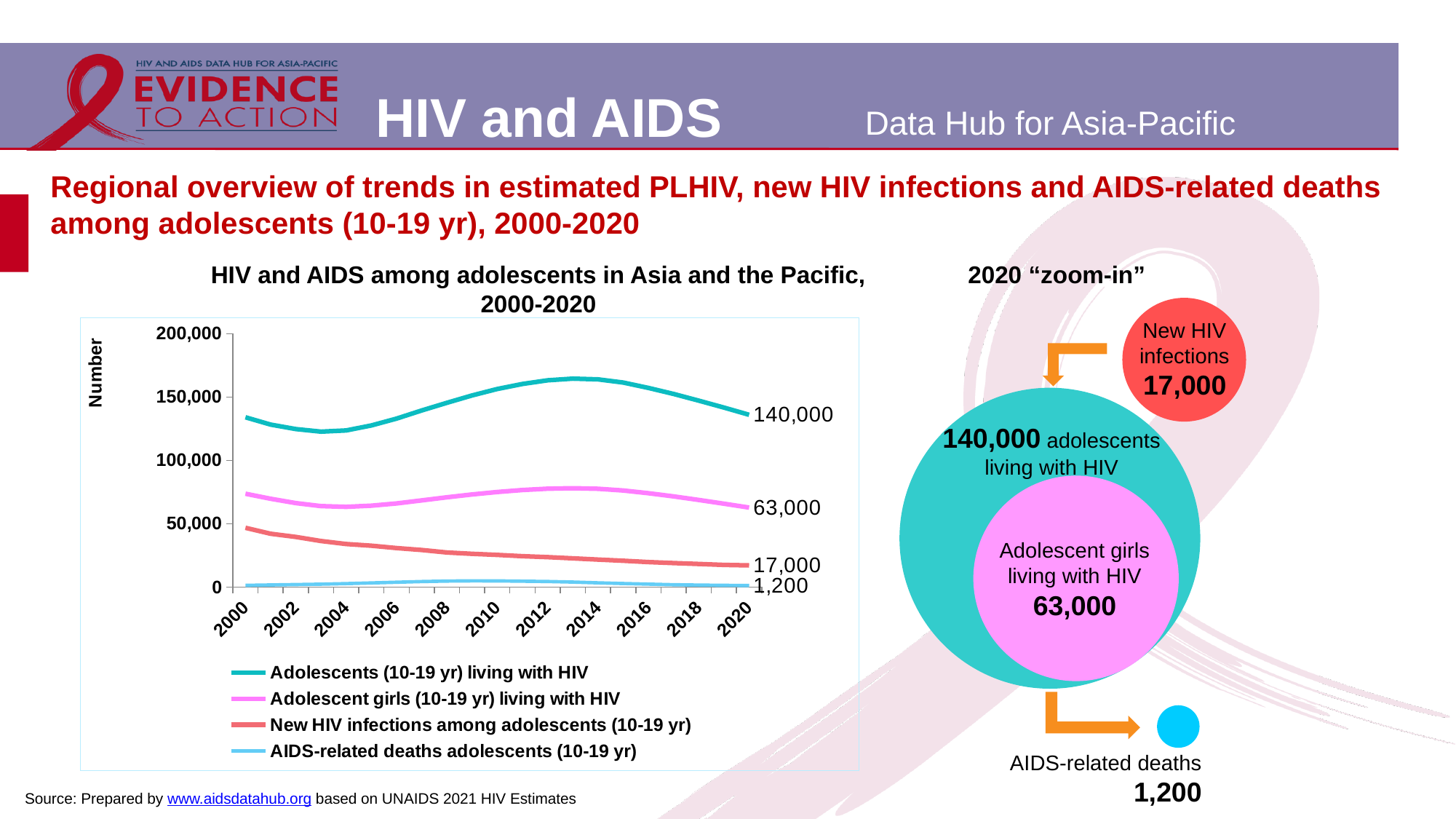
What kind of chart is shown on the slide? line chart What is the title of the y axis? Number What is the value for Adolescent girls (10-19 yr) living with HIV in 2020? 63,000 How many series does the legend list? 4 What is the value for AIDS-related deaths adolescents (10-19 yr) in 2020? 1,200 Do the values for New HIV infections among adolescents (10-19 yr) rise or fall from 2000 to 2020? fall What is the value for New HIV infections among adolescents (10-19 yr) in 2020? 17,000 Is the value for Adolescent girls (10-19 yr) living with HIV in 2000 greater or less than 100,000? less What is the difference between the 2020 values for Adolescents (10-19 yr) living with HIV and Adolescent girls (10-19 yr) living with HIV? 77,000 Is the value for Adolescents (10-19 yr) living with HIV in 2000 greater or less than 100,000? greater What is the value for Adolescents (10-19 yr) living with HIV in 2020? 140,000 In 2020, which is larger: Adolescent girls (10-19 yr) living with HIV or New HIV infections among adolescents (10-19 yr)? Adolescent girls (10-19 yr) living with HIV